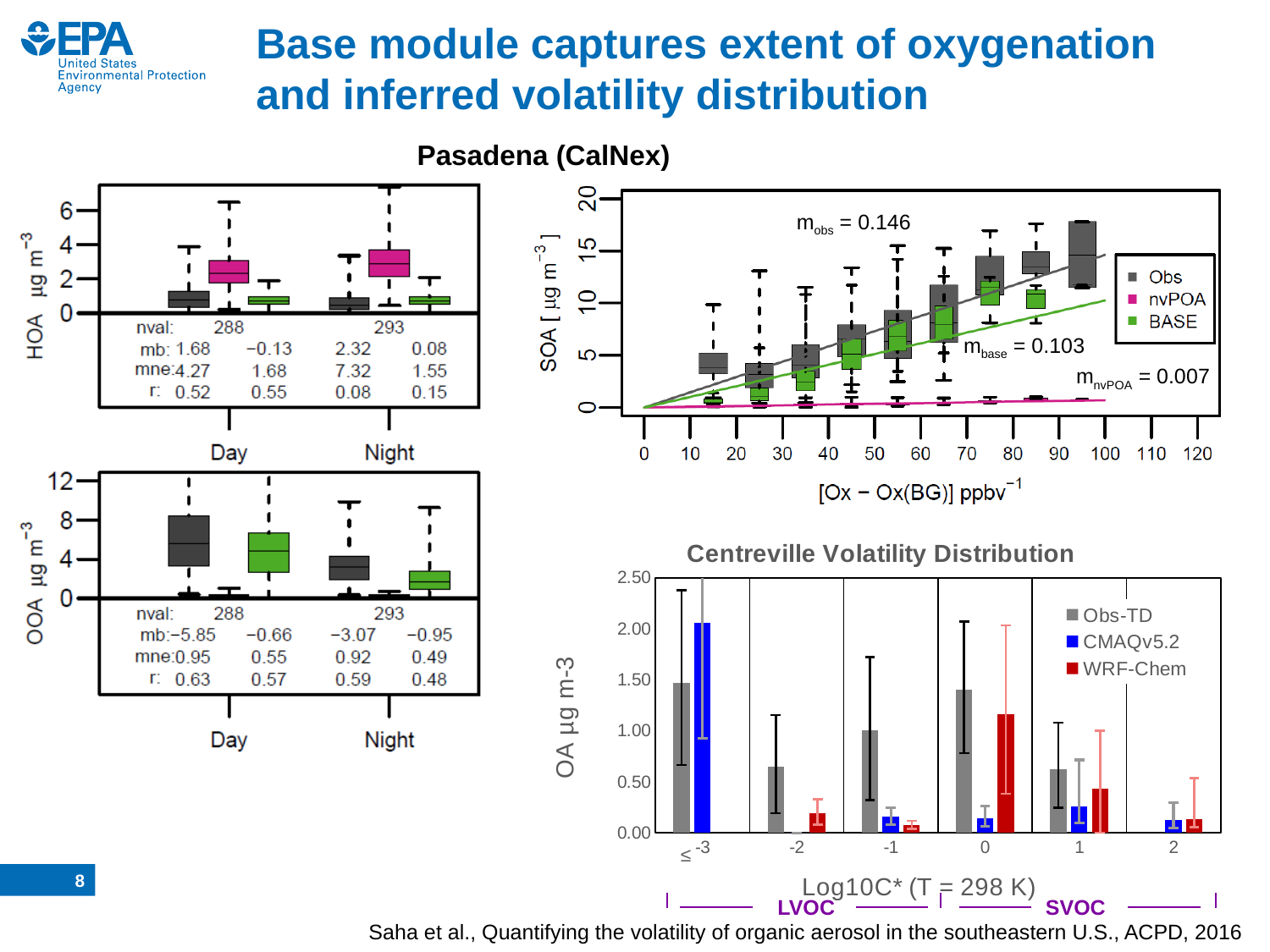
In the Centreville Volatility Distribution chart, is the Obs-TD value at the ≤-3 category greater or less than 1.00? greater In the Centreville Volatility Distribution chart, which series has the tallest bar at the ≤-3 category? CMAQv5.2 In the Centreville Volatility Distribution chart, is the CMAQv5.2 value at the ≤-3 category greater or less than 1.50? greater What kind of chart is the Centreville Volatility Distribution chart? bar chart In the Centreville Volatility Distribution chart, how many Log10C* categories are shown on the x axis? 6 In the SOA versus [Ox − Ox(BG)] chart, which series does the legend list in green? BASE In the SOA versus [Ox − Ox(BG)] chart, what is the value of m_obs? 0.146 In the Centreville Volatility Distribution chart, is the WRF-Chem value at the -2 category greater or less than 0.50? less In the Centreville Volatility Distribution chart, how many series does the legend list? 3 In the HOA box plot, what is the nval for Night? 293 In the SOA versus [Ox − Ox(BG)] chart, what is the difference between m_obs and m_base? 0.043 In the SOA versus [Ox − Ox(BG)] chart, what is the value of m_base? 0.103